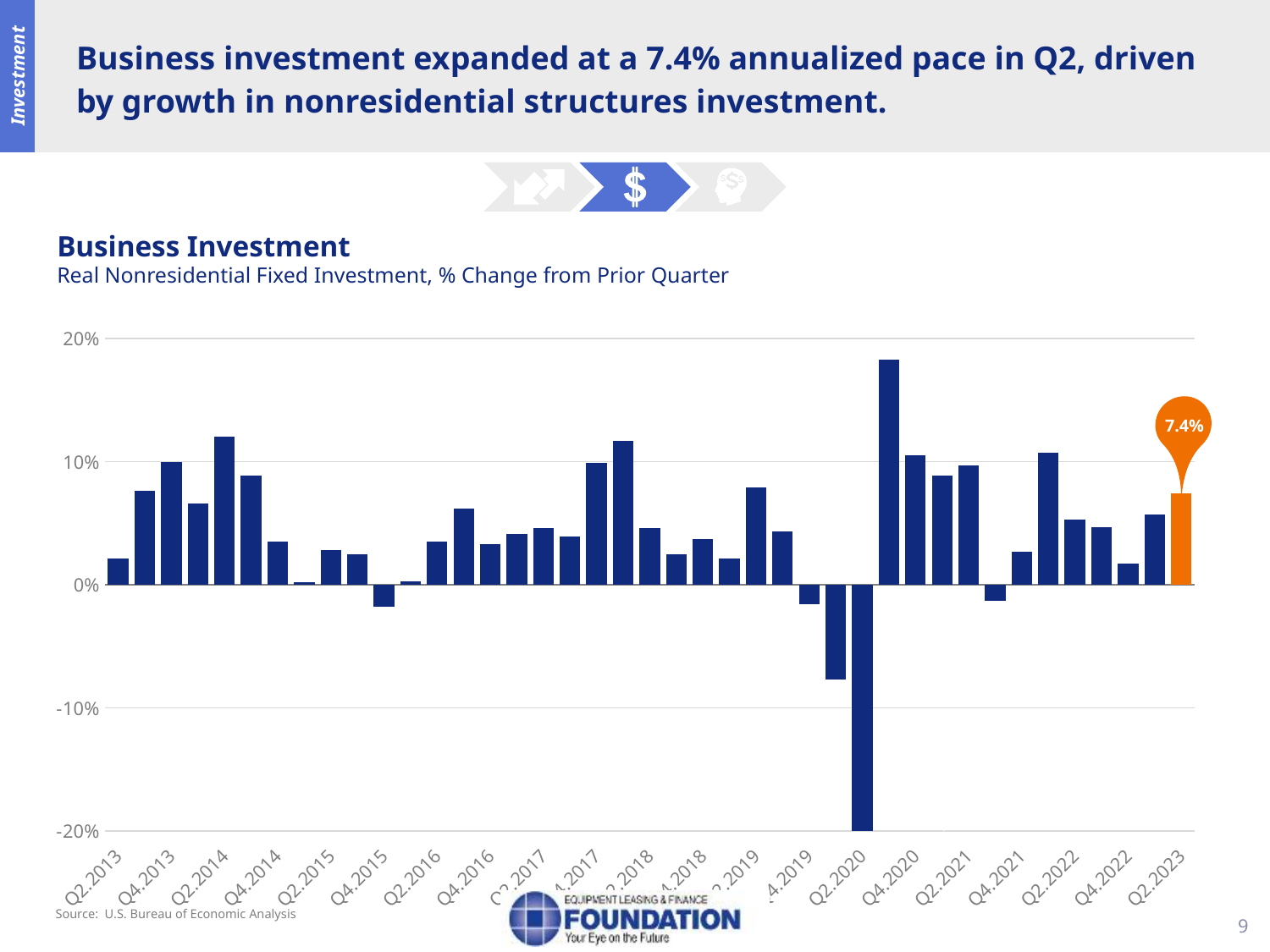
Which is larger, the value for Q2.2020 or the value for Q4.2020? Q4.2020 Which is larger, the value for Q2.2023 or the value for Q4.2022? Q2.2023 How many quarterly bars are plotted in the chart? 41 Is the value for Q2.2014 greater or less than 10%? greater Which bar is highlighted in orange rather than blue? Q2.2023 Which quarter has the lowest value in the chart? Q2.2020 What is the title of the chart? Business Investment Is the value for Q4.2022 greater or less than 10%? less What is the value for Q2.2023? 7.4% What kind of chart is shown on the slide? bar chart Is the value for Q2.2020 greater or less than -10%? less Do the values rise or fall from Q4.2022 to Q2.2023? rise